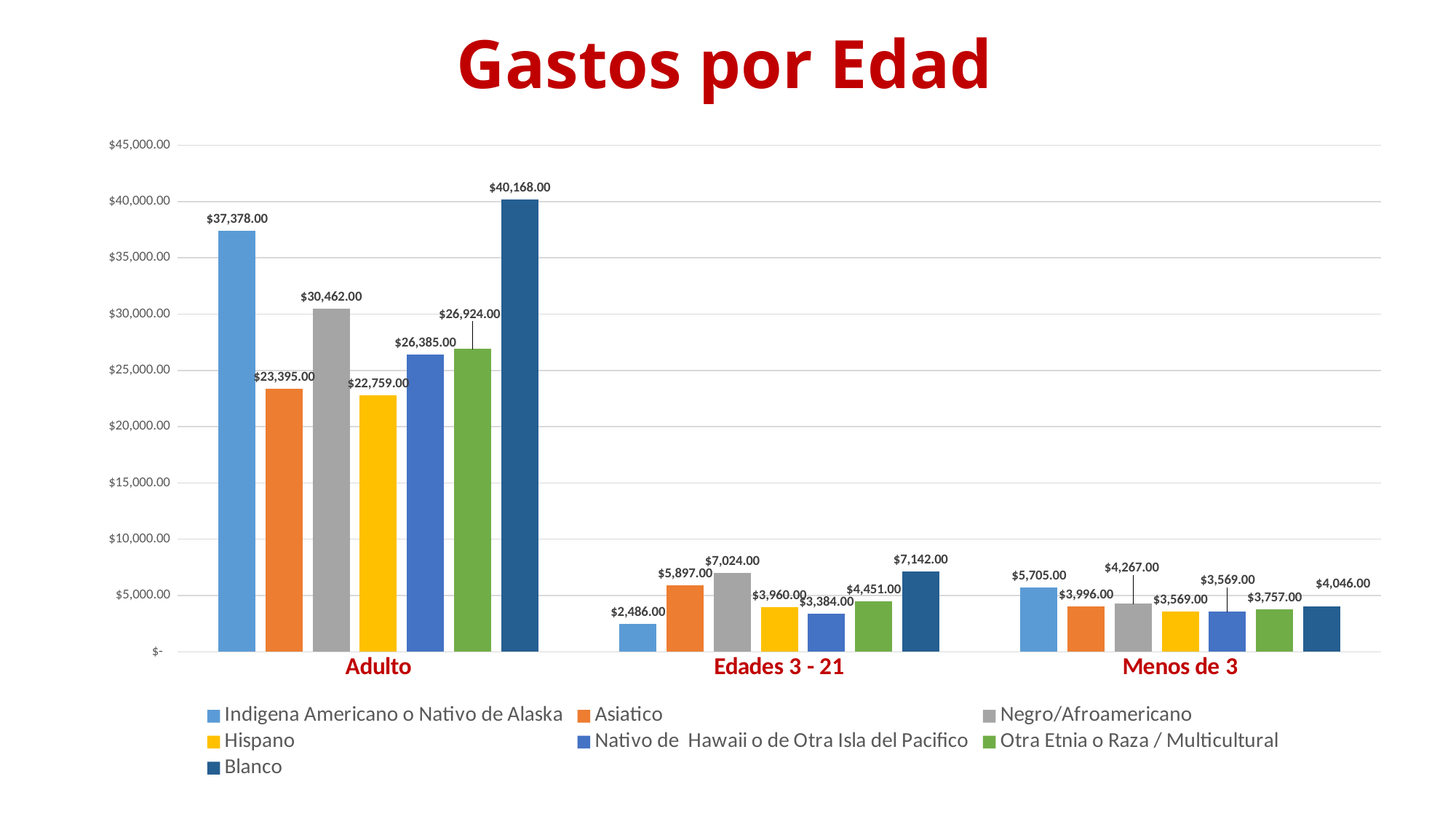
Is the value for Negro/Afroamericano in the Adulto category greater or less than $30,000.00? greater What is the difference between the Blanco and Indigena Americano o Nativo de Alaska values in the Adulto category? $2,790.00 What is the title of the chart? Gastos por Edad What is the value for Indigena Americano o Nativo de Alaska in the Menos de 3 category? $5,705.00 Which series has the highest value in the Adulto category? Blanco What is the value for Hispano in the Edades 3 - 21 category? $3,960.00 In the Menos de 3 category, which is larger: the value for Asiatico or the value for Blanco? Blanco How many series does the legend list? 7 Which series has the lowest value in the Edades 3 - 21 category? Indigena Americano o Nativo de Alaska What type of chart is shown on the slide? Bar chart How many age categories are shown on the x axis? 3 What is the value for Blanco in the Adulto category? $40,168.00